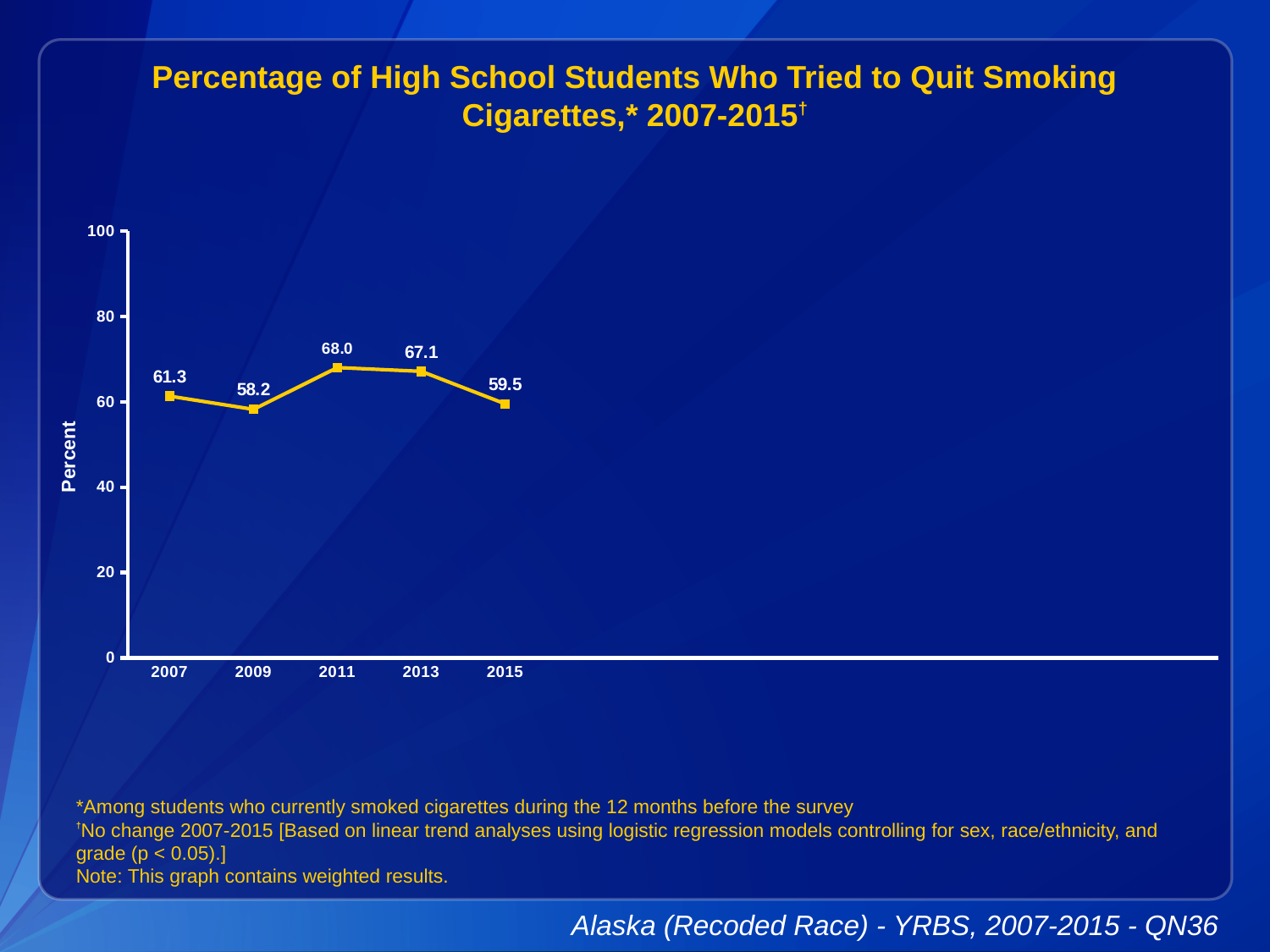
Which year has the lowest percentage of students who tried to quit smoking? 2009 What is the value plotted for 2015? 59.5 What kind of chart is shown on the slide? Line chart Does the value rise or fall from 2013 to 2015? Fall How many years are plotted on the chart? 5 What is the difference between the 2011 value and the 2009 value? 9.8 Which year has the highest percentage of students who tried to quit smoking? 2011 What percentage of high school students tried to quit smoking cigarettes in 2011? 68.0 What is the label on the y axis? Percent Which year has a larger value, 2007 or 2013? 2013 What is the value plotted for 2007? 61.3 Is the value for 2013 greater or less than 60? greater